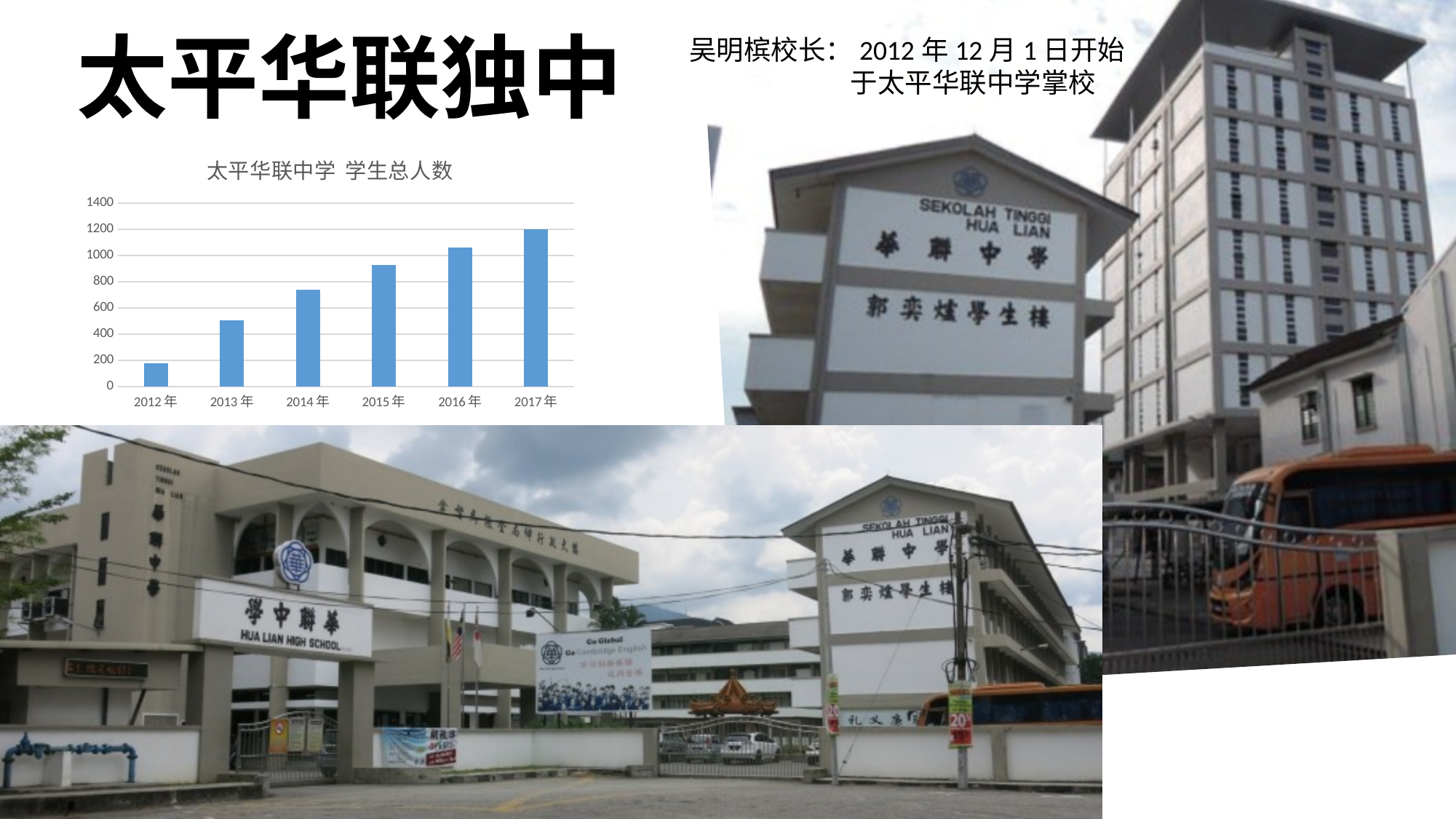
What is the title of the chart? 太平华联中学 学生总人数 Which is larger, the value for 2014年 or the value for 2016年? 2016年 What is the highest value shown on the y axis of the chart? 1400 Do the values rise or fall from 2012年 to 2017年? rise What kind of chart is shown on the slide? bar chart Is the value for 2012年 greater or less than 200? less Which year has the highest value in the chart? 2017年 Is the value for 2015年 greater or less than 1000? less Is the value for 2016年 greater or less than 1000? greater Which year has the lowest value in the chart? 2012年 How many years are shown on the x axis of the chart? 6